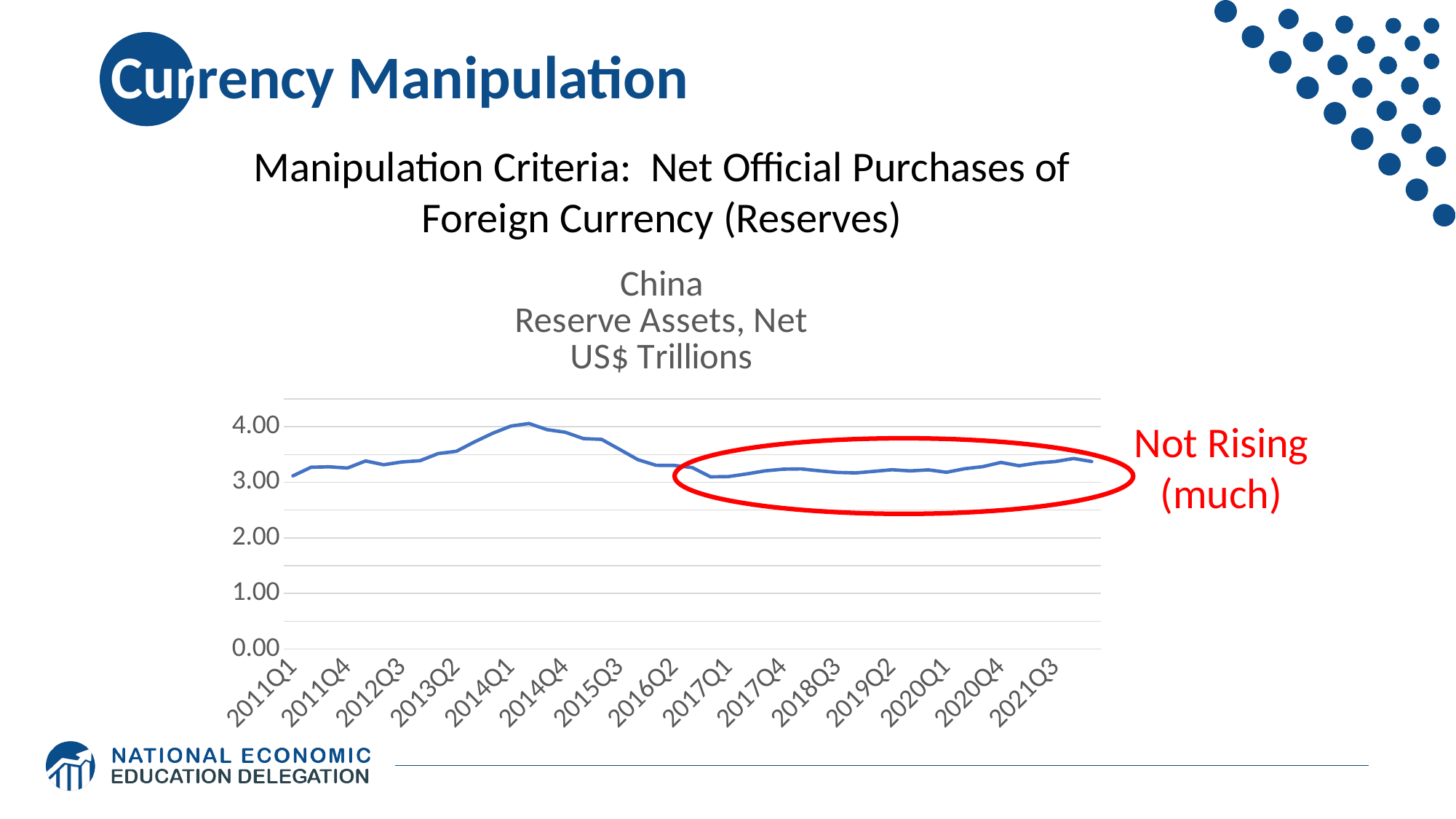
What kind of chart is shown on the slide? Line chart Is the value for 2013Q2 greater or less than 3.00? greater How many period labels are shown along the x axis? 15 Which is larger, the value for 2014Q1 or the value for 2017Q1? 2014Q1 Do the values rise or fall between 2014Q4 and 2016Q2? fall Is the value for 2017Q1 greater or less than 2.00? greater Is the value for 2014Q1 greater or less than 3.00? greater Which is larger, the value for 2013Q2 or the value for 2011Q4? 2013Q2 Which country's reserve assets does the chart show? China In what units are the values on the chart expressed? US$ Trillions Do the values rise or fall between 2011Q1 and 2014Q1? rise